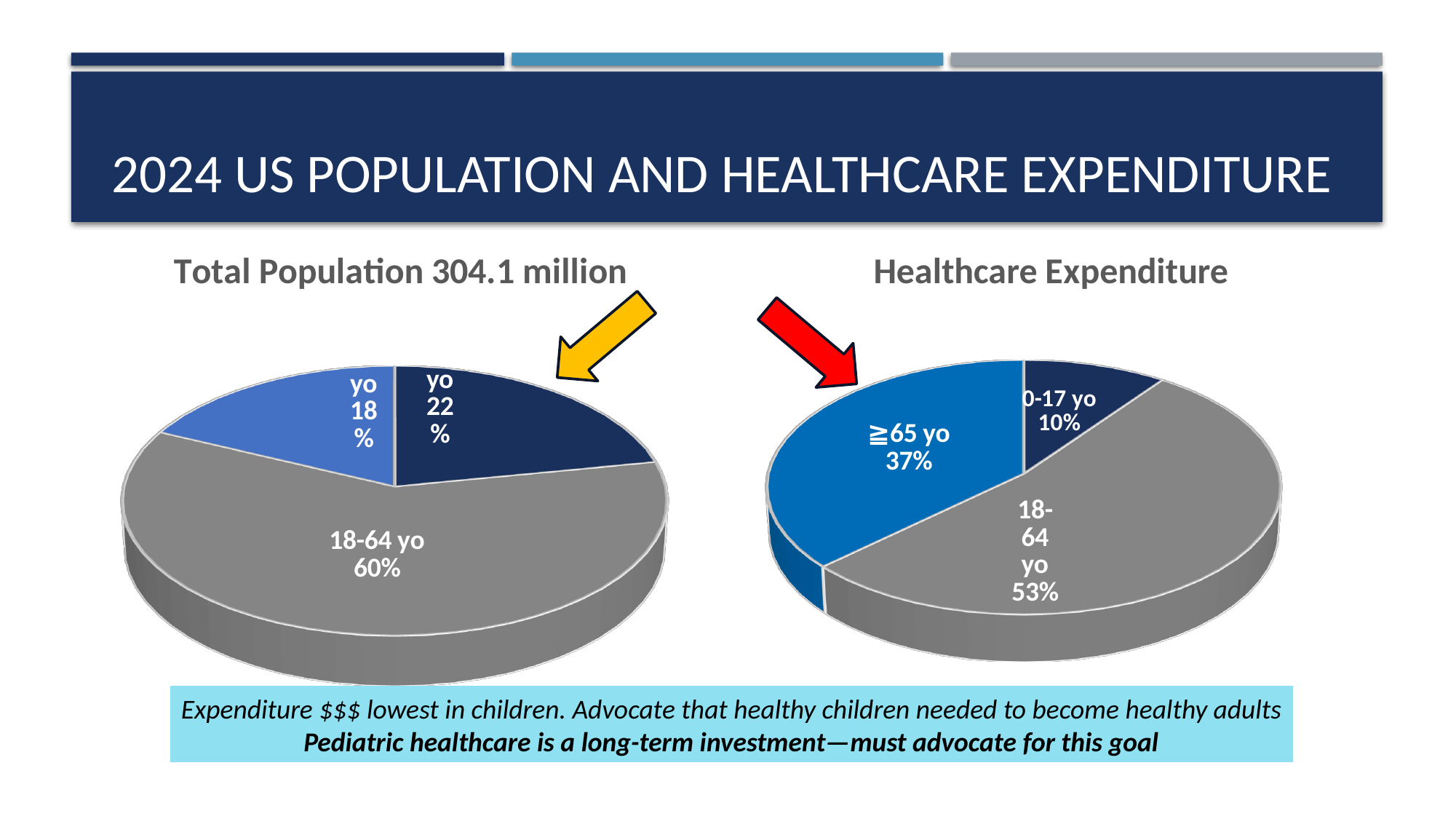
In the Healthcare Expenditure chart, what share of expenditure goes to the 0-17 yo group? 10% How many slices does the Healthcare Expenditure chart have? 3 What is the title of the chart on the right side of the slide? Healthcare Expenditure In the Healthcare Expenditure chart, what share of expenditure goes to the 18-64 yo group? 53% What kind of chart is the Total Population 304.1 million chart? Pie chart In the Healthcare Expenditure chart, which is larger: the share for ≧65 yo or for 0-17 yo? ≧65 yo In the Total Population 304.1 million chart, what share of the population is 18-64 yo? 60% In the Healthcare Expenditure chart, what share of expenditure goes to the ≧65 yo group? 37% In the Healthcare Expenditure chart, which age group has the smallest share? 0-17 yo In the Healthcare Expenditure chart, which age group has the largest share? 18-64 yo In the Healthcare Expenditure chart, what is the difference in percentage points between the 18-64 yo and ≧65 yo shares? 16 In the Total Population 304.1 million chart, which age group has the largest share? 18-64 yo